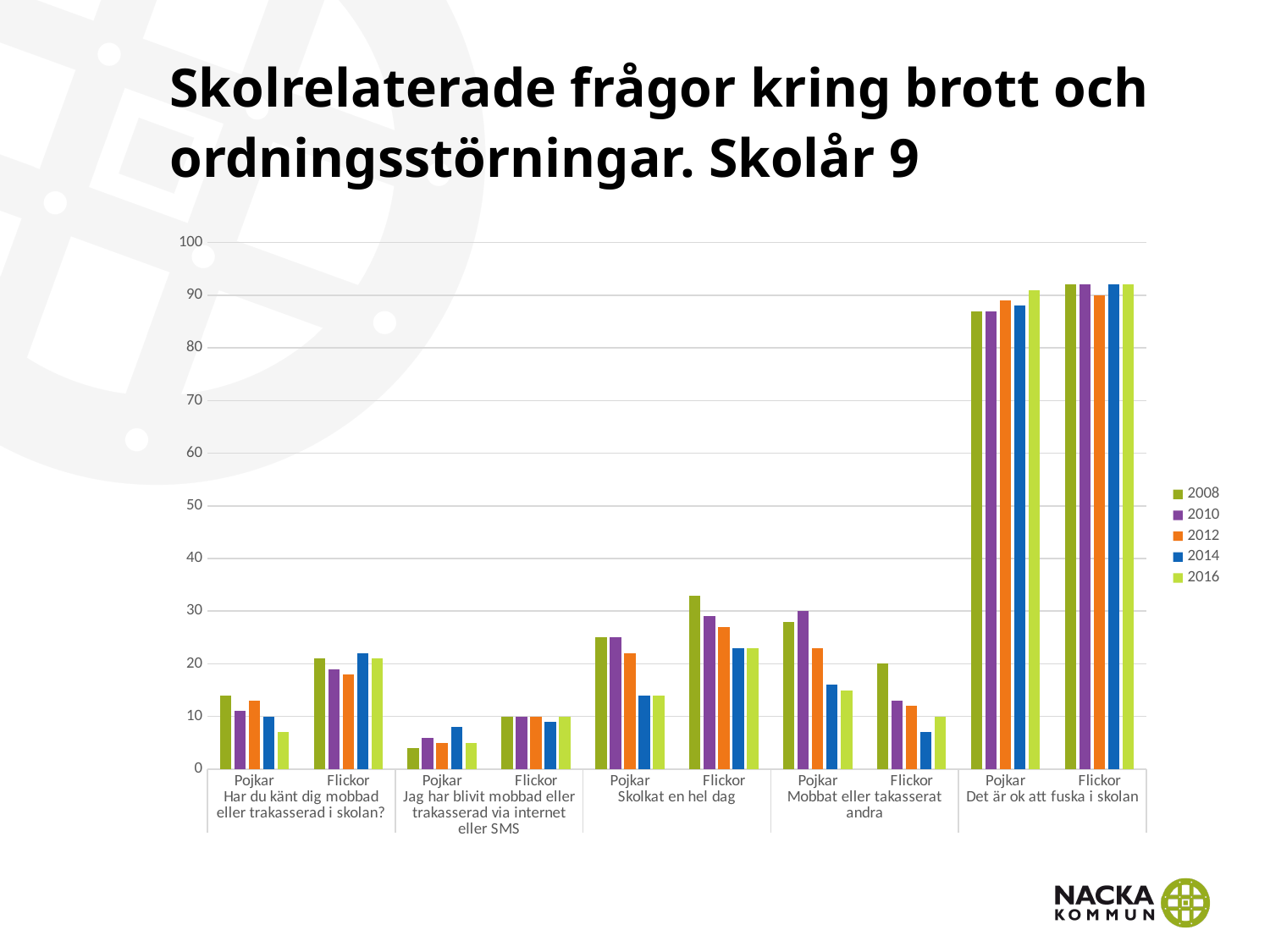
Is the 2008 value for Pojkar under 'Det är ok att fuska i skolan' greater or less than 80? greater For 2008 under 'Mobbat eller trakasserat andra', which is larger, Pojkar or Flickor? Pojkar Which years are listed in the legend? 2008, 2010, 2012, 2014, 2016 How many survey questions are shown as groups along the x axis? 5 Is the 2008 value for Flickor under 'Skolkat en hel dag' greater or less than 30? greater How many series does the legend list? 5 What kind of chart is shown on the slide? bar chart For 2016 under 'Har du känt dig mobbad eller trakasserad i skolan?', which is larger, Pojkar or Flickor? Flickor For Flickor under 'Skolkat en hel dag', which year has the highest value? 2008 For Pojkar under 'Har du känt dig mobbad eller trakasserad i skolan?', which year has the lowest value? 2016 Is the 2008 value for Pojkar under 'Jag har blivit mobbad eller trakasserad via internet eller SMS' greater or less than 10? less